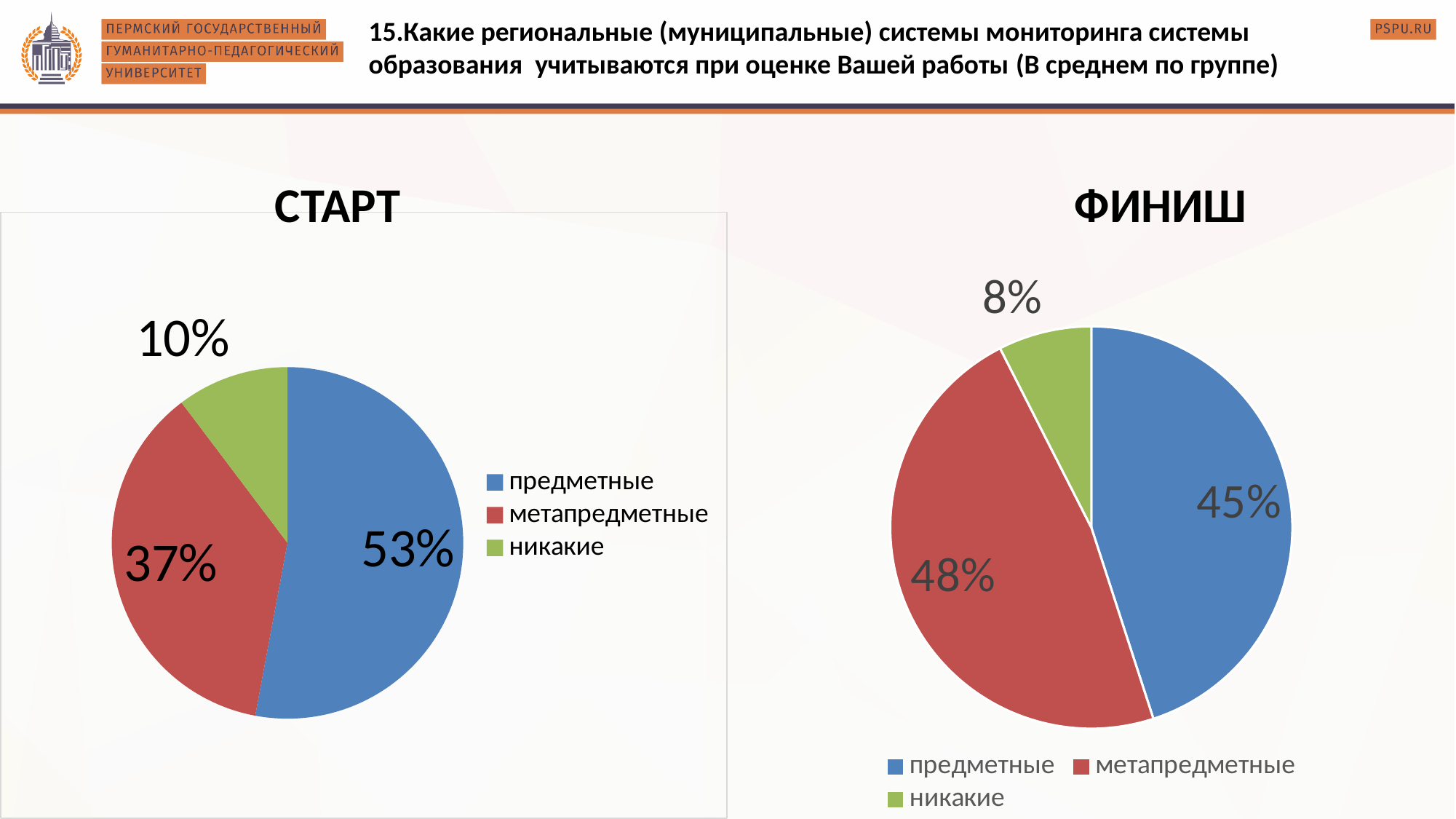
In the СТАРТ chart, what is the difference between the предметные and метапредметные shares? 16% In the СТАРТ chart, what share is labelled for предметные? 53% In the ФИНИШ chart, which is larger: предметные or метапредметные? метапредметные In the ФИНИШ chart, which category has the smallest slice? никакие In the ФИНИШ chart, what share is labelled for никакие? 8% In the СТАРТ chart, what share is labelled for метапредметные? 37% In the СТАРТ chart, which category has the largest slice? предметные In the СТАРТ chart, what share is labelled for никакие? 10% How many categories does the legend of the СТАРТ chart list? 3 In the ФИНИШ chart, what share is labelled for предметные? 45% In the ФИНИШ chart, what share is labelled for метапредметные? 48% What type of chart is the ФИНИШ chart? pie chart